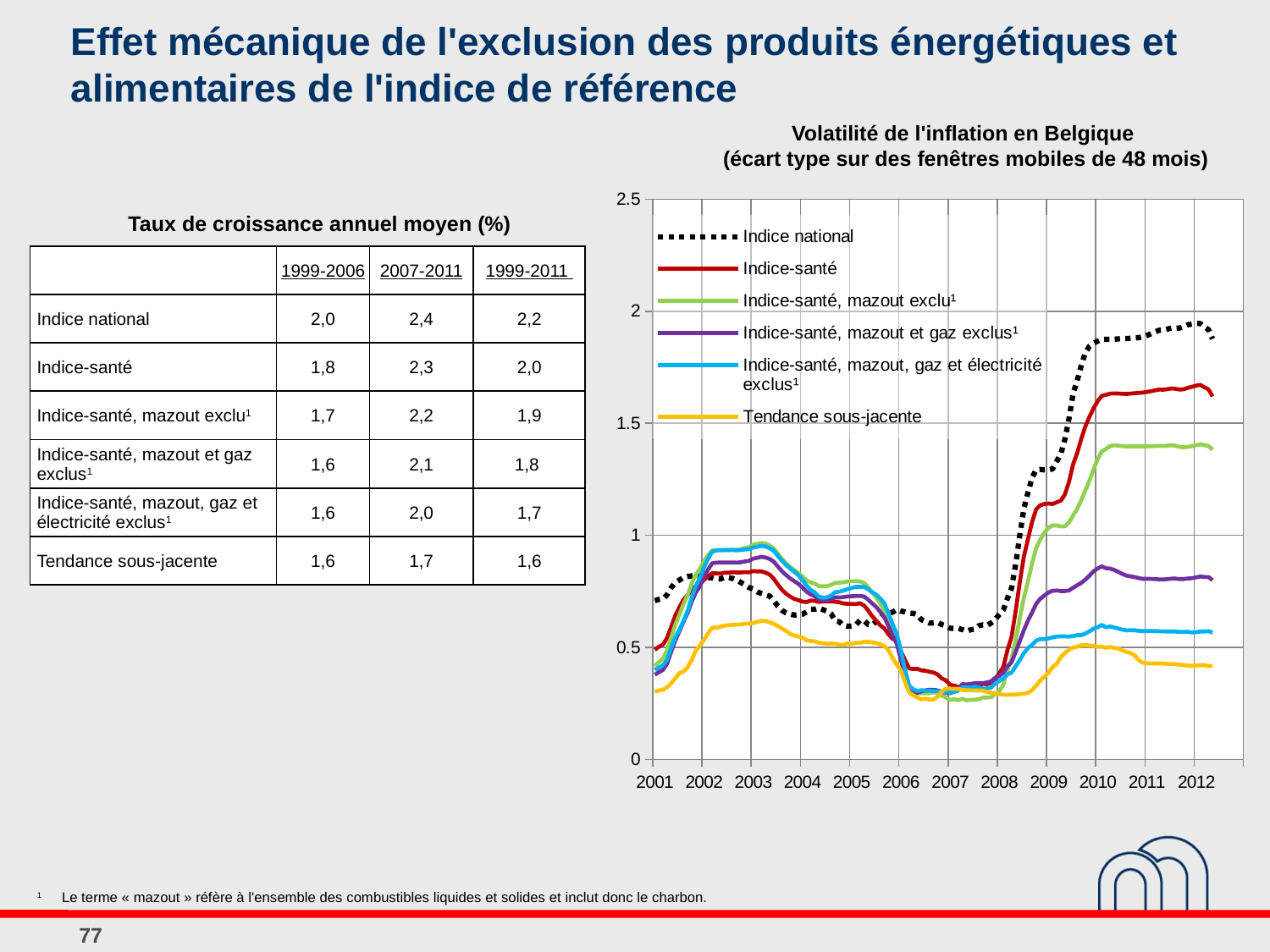
In the chart 'Volatilité de l'inflation en Belgique', does the Indice national series rise or fall between 2008 and 2010? rise In the chart 'Volatilité de l'inflation en Belgique', is the value of Tendance sous-jacente in 2012 greater or less than 1? less In the chart 'Volatilité de l'inflation en Belgique', which is larger in 2012: Indice-santé or Indice-santé, mazout exclu? Indice-santé How many years are labelled on the x axis of the chart 'Volatilité de l'inflation en Belgique'? 12 How many series does the legend of the chart 'Volatilité de l'inflation en Belgique' list? 6 In the chart 'Volatilité de l'inflation en Belgique', is the value of Indice national in 2012 greater or less than 1.5? greater What kind of chart is shown on the right of the slide? Line chart In the chart 'Volatilité de l'inflation en Belgique', which series is drawn as a dotted black line? Indice national In the chart 'Volatilité de l'inflation en Belgique', is the value of Indice-santé, mazout et gaz exclus in 2011 greater or less than 1? less In the chart 'Volatilité de l'inflation en Belgique', which series has the highest value in 2012? Indice national In the chart 'Volatilité de l'inflation en Belgique', which series has the lowest value in 2012? Tendance sous-jacente What is the title of the chart on the right of the slide? Volatilité de l'inflation en Belgique (écart type sur des fenêtres mobiles de 48 mois)